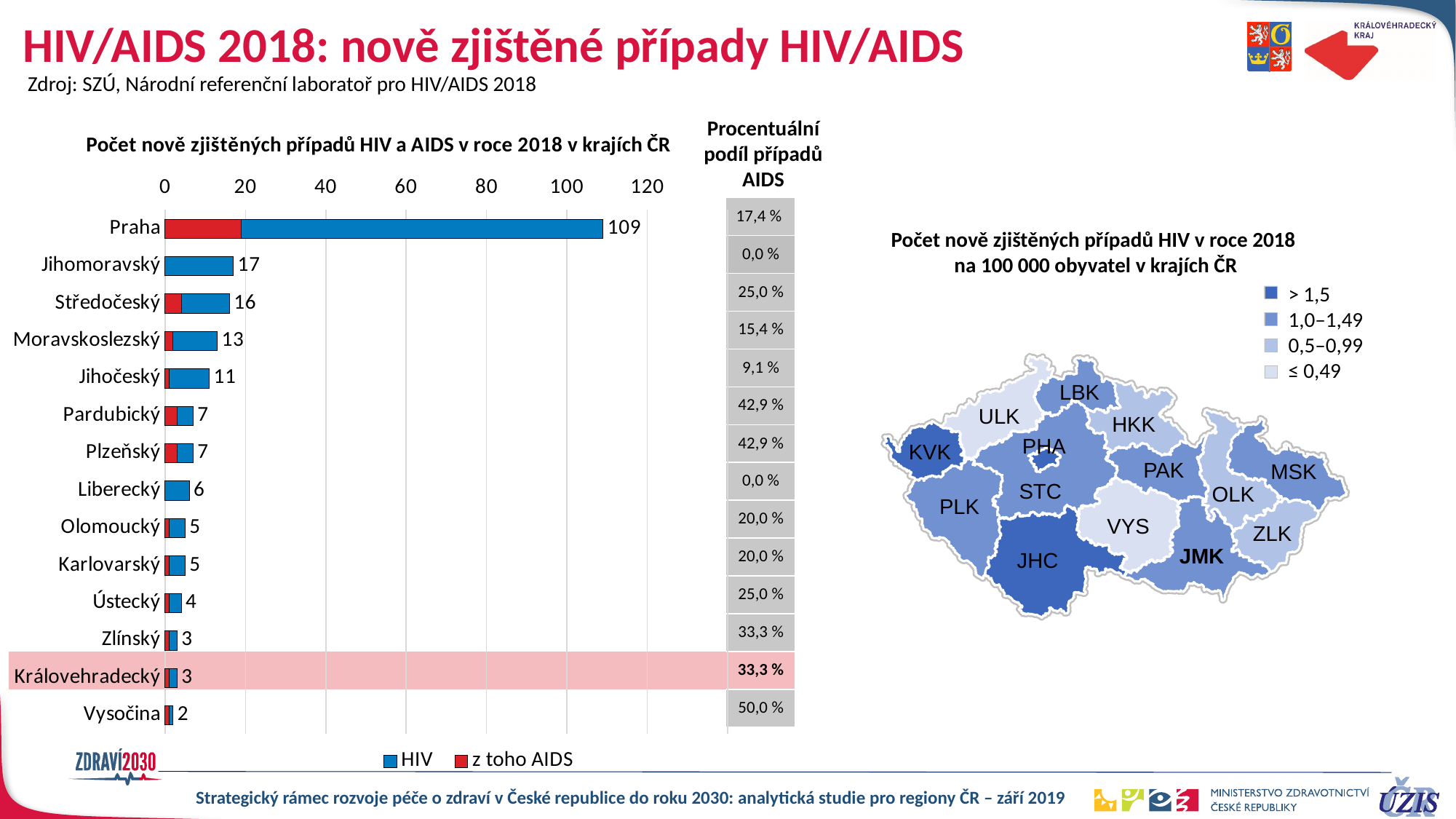
How many series does the bar chart's legend list? 2 In the bar chart, which region has the highest value? Praha In the bar chart, which region has the lowest value? Vysočina In the bar chart, what is the difference between the values for Praha and Jihomoravský? 92 In the column 'Procentuální podíl případů AIDS', what percentage is shown for Vysočina? 50,0 % In the bar chart, what is the value shown for Jihomoravský? 17 In the bar chart, what is the value shown for Královehradecký? 3 In the bar chart, what is the value shown for Praha? 109 How many regions are shown in the bar chart? 14 In the bar chart, is the value for Praha greater or less than 100? greater What kind of chart is the chart on the left of the slide? bar chart In the bar chart, which region has a larger value, Středočeský or Moravskoslezský? Středočeský